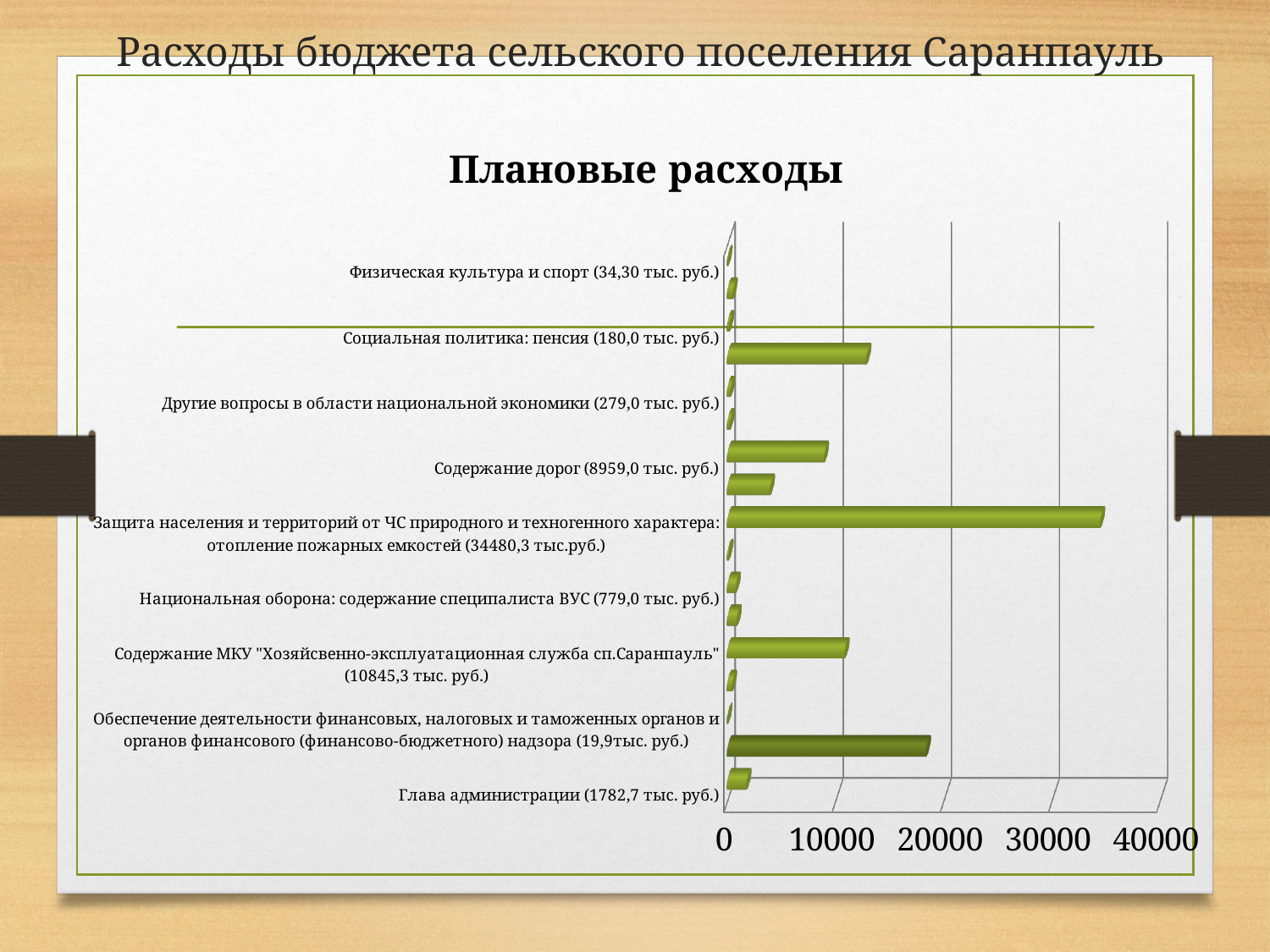
What value is given in the category label for Содержание дорог? 8959,0 тыс. руб. What is the title of the chart? Плановые расходы What is the difference between the labelled values for Содержание МКУ "Хозяйсвенно-эксплуатационная служба сп.Саранпауль" (10845,3) and Содержание дорог (8959,0)? 1886,3 тыс. руб. Which is larger: the value for Содержание дорог or the value for Содержание МКУ "Хозяйсвенно-эксплуатационная служба сп.Саранпауль"? Содержание МКУ "Хозяйсвенно-эксплуатационная служба сп.Саранпауль" What value is given in the category label for Глава администрации? 1782,7 тыс. руб. Is the longest bar in the chart greater or less than 30000? greater Which category has the smallest planned expenditure? Обеспечение деятельности финансовых, налоговых и таможенных органов и органов финансового (финансово-бюджетного) надзора How many labelled categories are listed on the vertical axis of the chart? 9 What is the highest tick value shown on the horizontal axis of the chart? 40000 What kind of chart is shown on the slide? Bar chart Which category has the largest planned expenditure? Защита населения и территорий от ЧС природного и техногенного характера: отопление пожарных емкостей What value is given in the category label for Национальная оборона: содержание специпалиста ВУС? 779,0 тыс. руб.